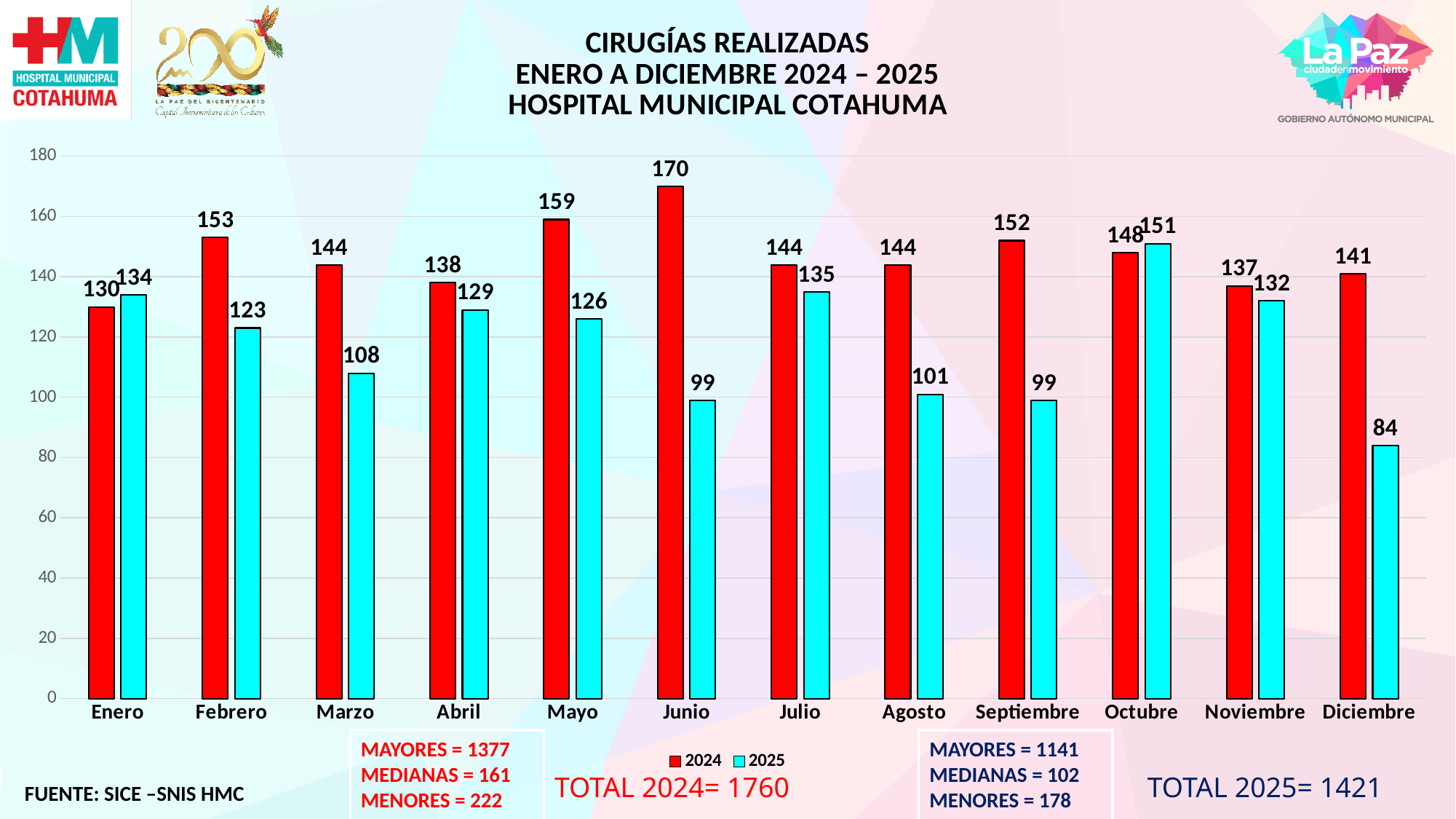
Which month has the highest value for the 2024 series? Junio What is the difference between the 2024 and 2025 values in Junio? 71 How many series does the legend list? 2 How many months are shown on the x axis? 12 What is the value for 2025 in Marzo? 108 What is the value for 2025 in Diciembre? 84 Which month has the lowest value for the 2025 series? Diciembre Which is larger in Octubre, the 2024 value or the 2025 value? 2025 Which is larger in Enero, the 2024 value or the 2025 value? 2025 What kind of chart is shown on the slide? Bar chart Which colour represents the 2025 series? Cyan What is the value for 2024 in Junio? 170